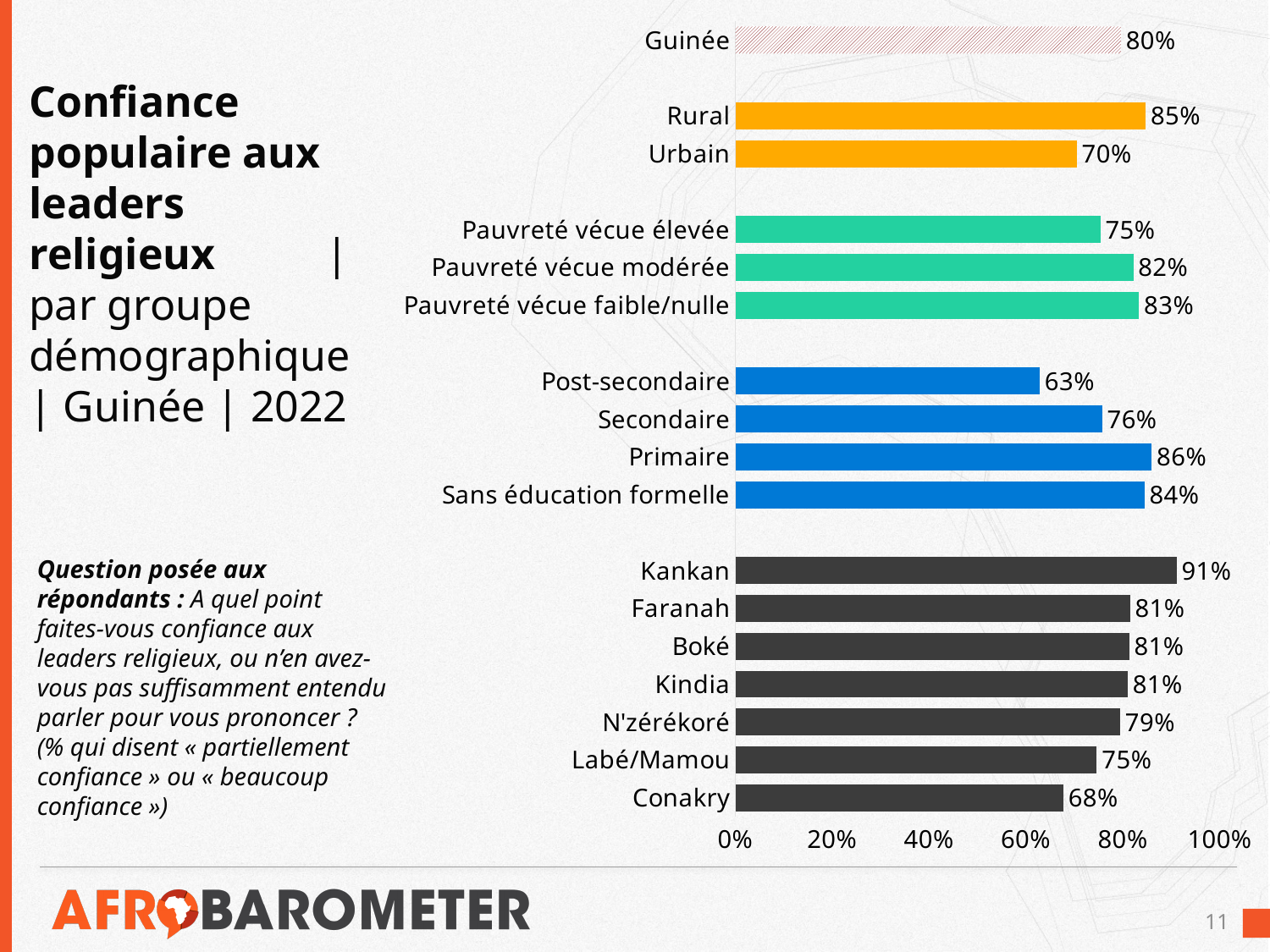
What is the value for Rural? 85% Which category has the lowest value? Post-secondaire Which is larger, the value for Primaire or the value for Secondaire? Primaire How many bars are plotted in the chart in total? 17 What is the value for Guinée? 80% What is the difference between the values for Rural and Urbain? 15% How many regions are shown in the bottom group (Kankan through Conakry)? 7 Which category has the lowest value among the regions (Kankan through Conakry)? Conakry What is the value for Post-secondaire? 63% Which category has the highest value? Kankan What is the difference between the values for Kankan and Conakry? 23% What type of chart is shown? Bar chart